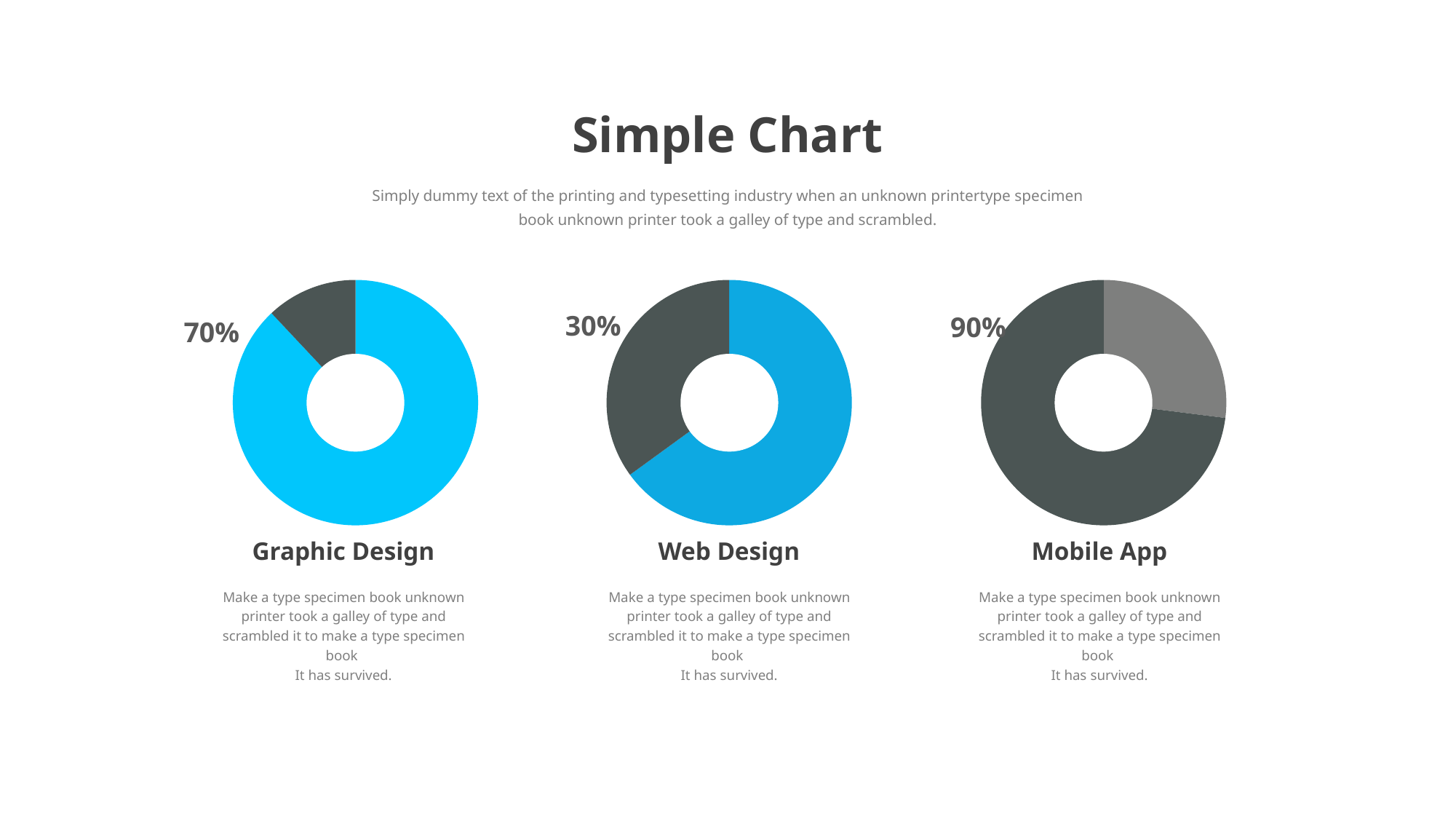
What is the difference between the percentages shown for Mobile App and Web Design? 60 percentage points How many donut charts are on the slide? 3 Which of the three charts shows the lowest percentage? Web Design What percentage is shown for the Web Design chart? 30% Which shows a larger percentage, Graphic Design or Mobile App? Mobile App What percentage is shown for the Graphic Design chart? 70% What is the title of the slide? Simple Chart What kind of chart is used for Graphic Design, Web Design and Mobile App? Donut (pie) chart What is the difference between the percentages shown for Graphic Design and Web Design? 40 percentage points What percentage is shown for the Mobile App chart? 90% How many slices does each donut chart have? 2 Which of the three charts shows the highest percentage? Mobile App